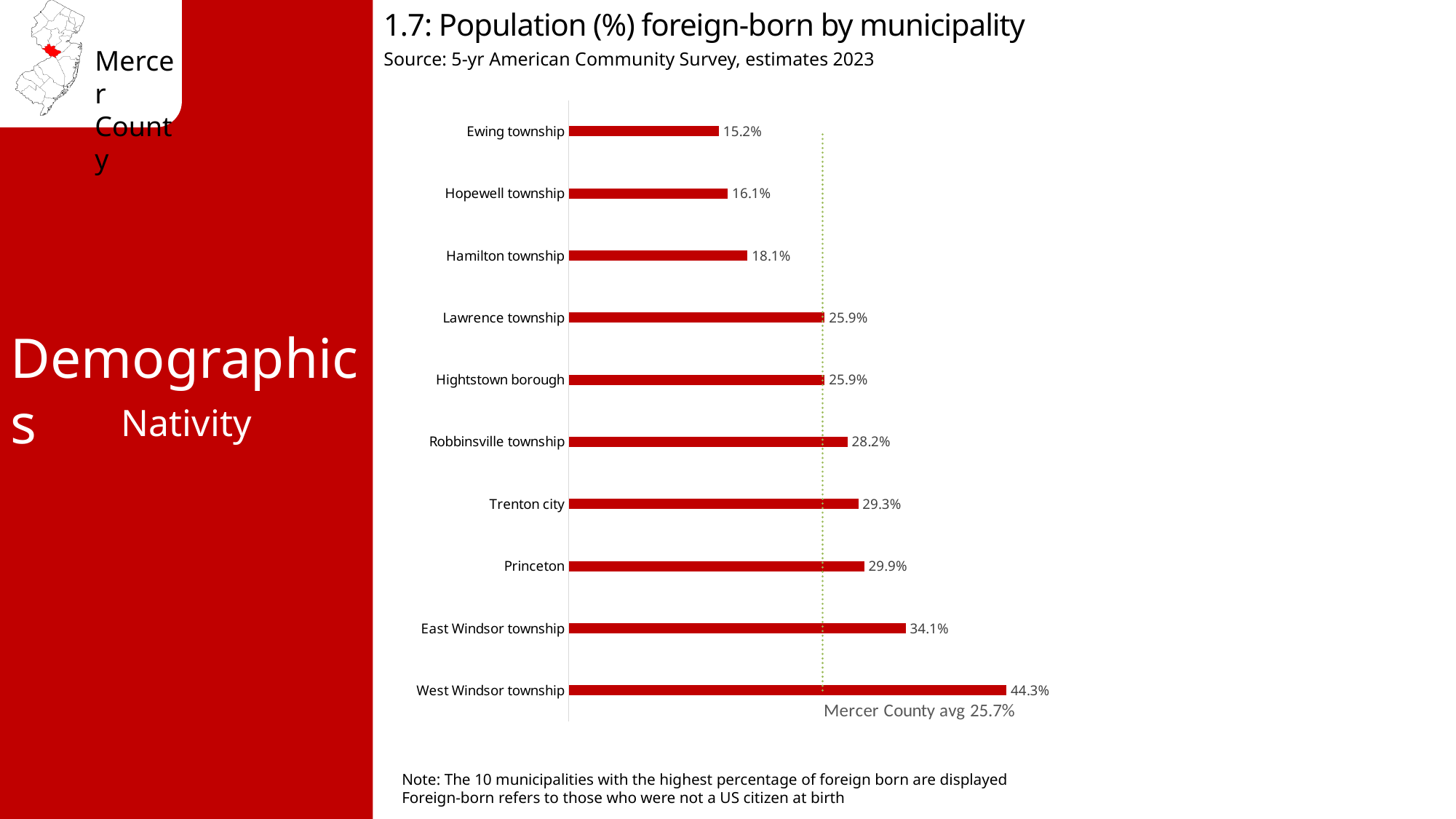
What is the Mercer County average foreign-born percentage shown by the dotted line? 25.7% What is the difference in foreign-born percentage between West Windsor township and East Windsor township? 10.2% Which municipality has the lowest percentage of foreign-born population? Ewing township Which has a higher foreign-born percentage, Princeton or Robbinsville township? Princeton What is the source of the data shown in the chart? 5-yr American Community Survey, estimates 2023 Which municipality has the highest percentage of foreign-born population? West Windsor township What is the percentage of foreign-born population for Ewing township? 15.2% What is the percentage of foreign-born population for West Windsor township? 44.3% What kind of chart is shown on the slide? Bar chart What is the difference in foreign-born percentage between Hamilton township and Hopewell township? 2.0% What is the percentage of foreign-born population for Trenton city? 29.3% How many municipalities are shown in the chart? 10